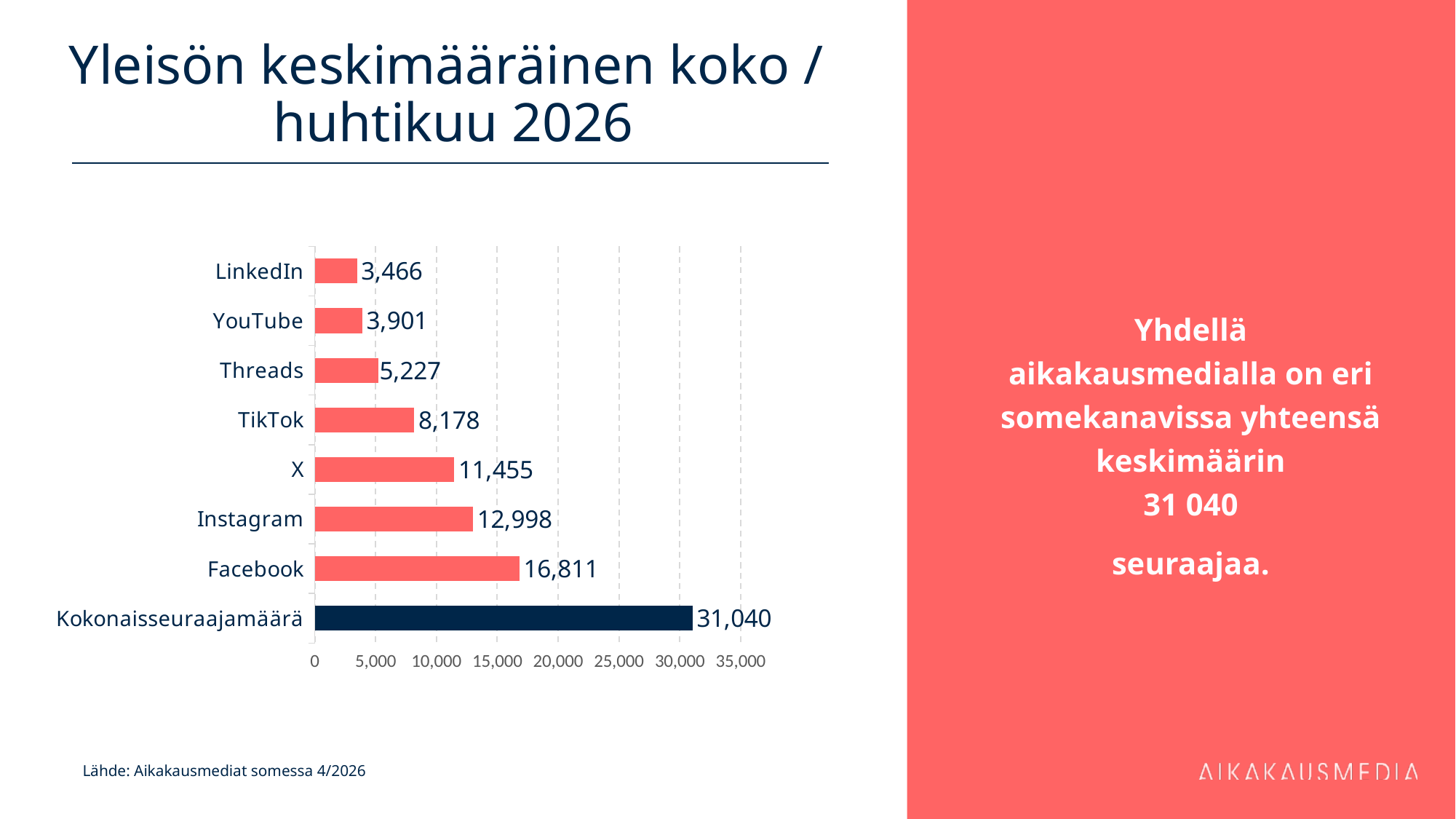
What is the value for Kokonaisseuraajamäärä? 31,040 Which is larger, the value for Threads or the value for YouTube? Threads Is the value for X greater or less than 10,000? greater Which category has the lowest value? LinkedIn Which category has the highest value? Kokonaisseuraajamäärä What is the value for Facebook? 16,811 What is the value for TikTok? 8,178 What is the title of the slide? Yleisön keskimääräinen koko / huhtikuu 2026 Which bar is coloured dark navy instead of red? Kokonaisseuraajamäärä How many categories are shown in the chart? 8 What is the difference between the values for Instagram and X? 1,543 What kind of chart is shown on the slide? bar chart